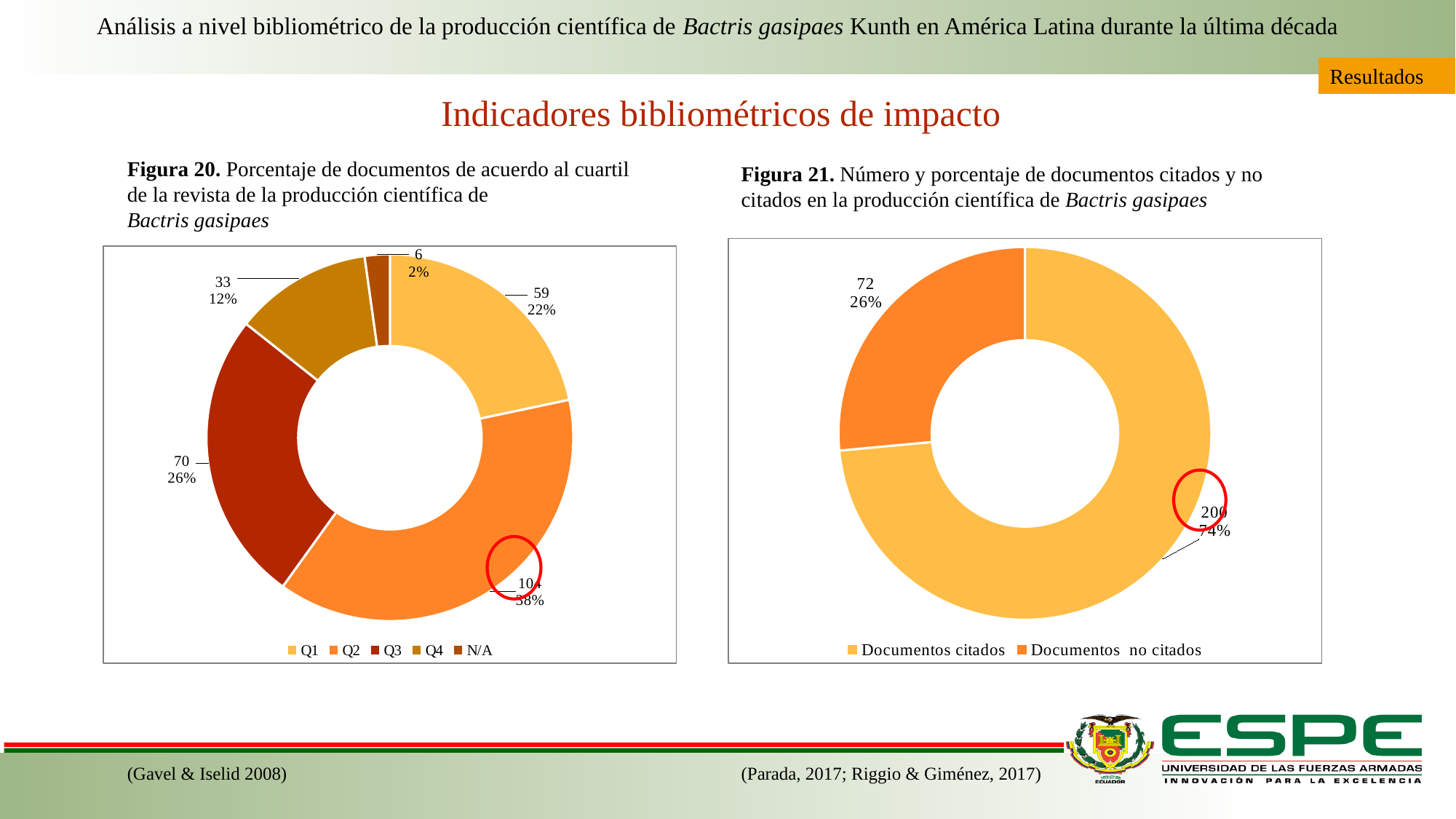
In Figura 20, how many documents are in quartile Q1? 59 In Figura 20, which category has the smallest share of documents? N/A In Figura 21, how many documents are not cited (Documentos no citados)? 72 In Figura 20, what percentage of documents are in quartile Q3? 26% In Figura 21, which category is larger, Documentos citados or Documentos no citados? Documentos citados In Figura 20, how many documents are in quartile Q4? 33 In Figura 20, what is the difference between the number of documents in Q3 and in Q1? 11 In Figura 20, what percentage of documents fall under N/A? 2% In Figura 20, how many categories does the legend list? 5 In Figura 20, which quartile category has the largest share of documents? Q2 In Figura 21, what percentage of documents are not cited? 26% What kind of chart is Figura 20? doughnut chart